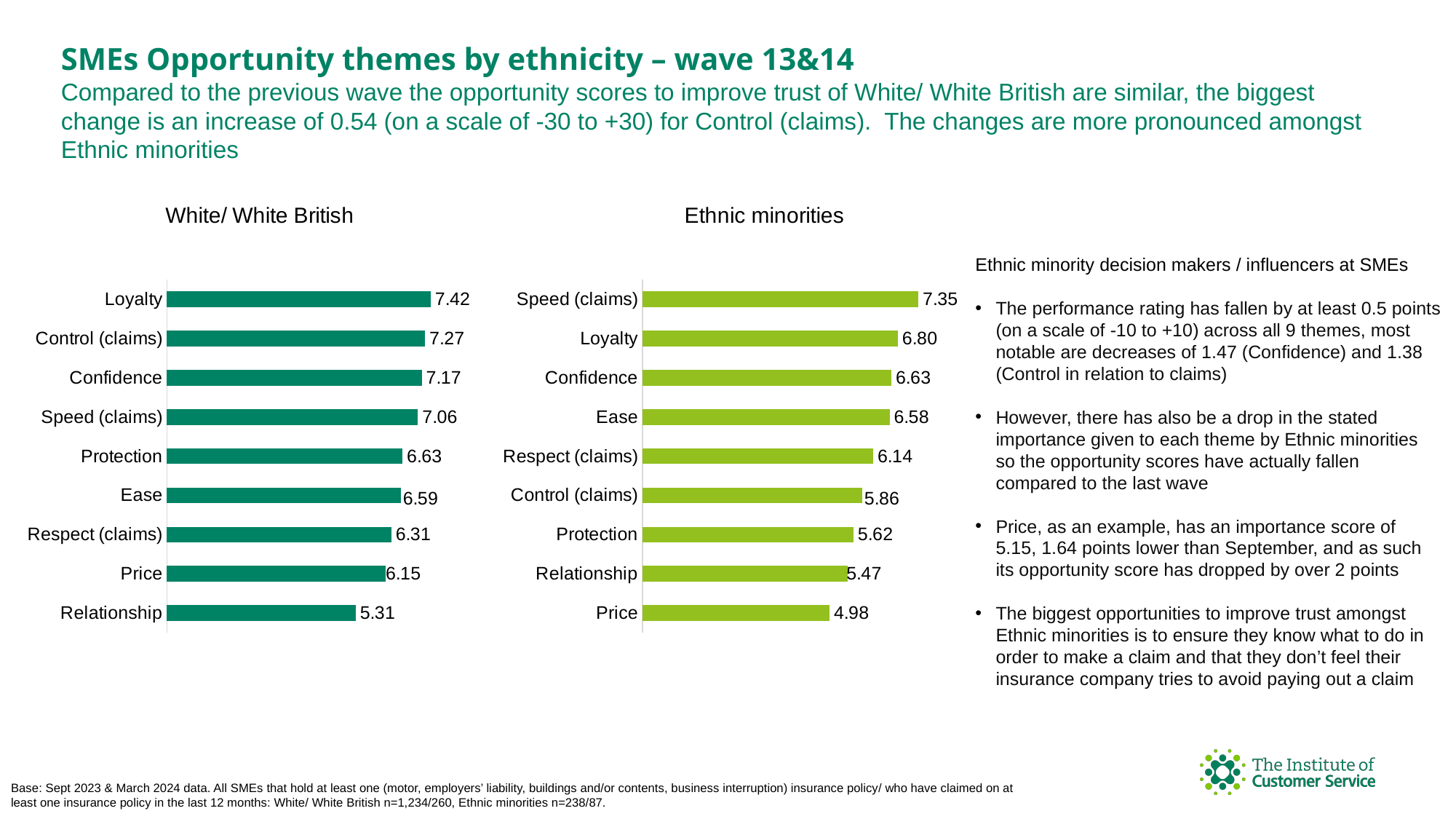
In the Ethnic minorities chart, which theme has the highest value? Speed (claims) In the White/ White British chart, what is the difference between the values for Loyalty and Relationship? 2.11 In the Ethnic minorities chart, what is the value for Control (claims)? 5.86 In the White/ White British chart, what is the value for Loyalty? 7.42 Which is larger: the value for Confidence in the White/ White British chart or the value for Confidence in the Ethnic minorities chart? White/ White British In the Ethnic minorities chart, what is the difference between the values for Speed (claims) and Price? 2.37 In the White/ White British chart, which theme has the lowest value? Relationship In the White/ White British chart, what is the value for Price? 6.15 How many themes are shown in the White/ White British chart? 9 What type of chart is the Ethnic minorities chart? Bar chart What colour are the bars in the Ethnic minorities chart? Light green In the Ethnic minorities chart, which theme has the lowest value? Price